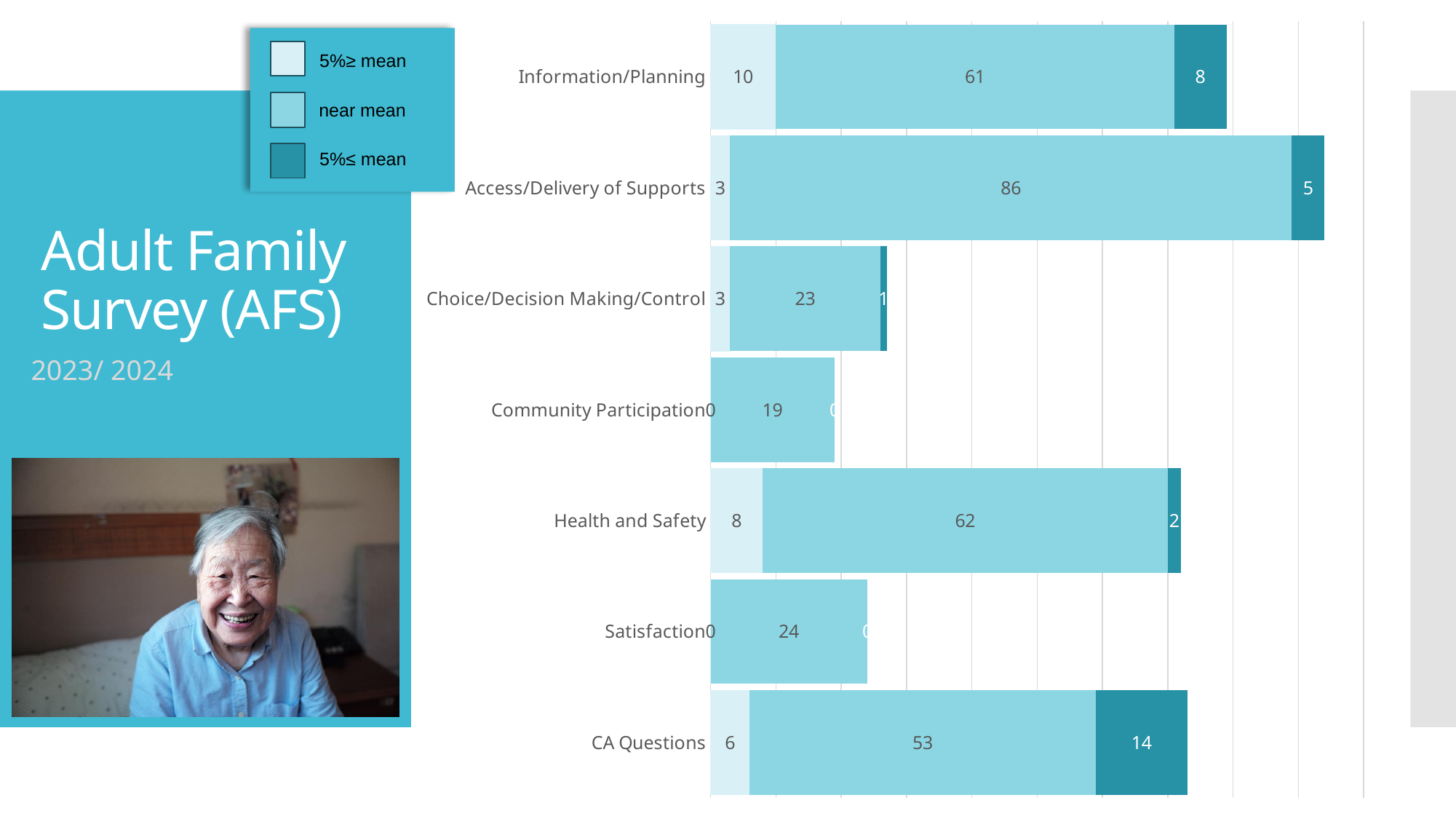
What is the '5%≤ mean' value for CA Questions? 14 How many series does the legend list? 3 Which is larger, the '5%≤ mean' value for CA Questions or for Information/Planning? CA Questions How many categories are plotted in the chart? 7 What is the 'near mean' value for Access/Delivery of Supports? 86 Which category has the highest 'near mean' value? Access/Delivery of Supports Which category has the lowest 'near mean' value? Community Participation What is the total of the stacked bar for CA Questions? 73 What is the total of the stacked bar for Access/Delivery of Supports? 94 What is the '5%≥ mean' value for Information/Planning? 10 What is the difference between the 'near mean' values for Health and Safety and Information/Planning? 1 What kind of chart is shown on the slide? Stacked bar chart